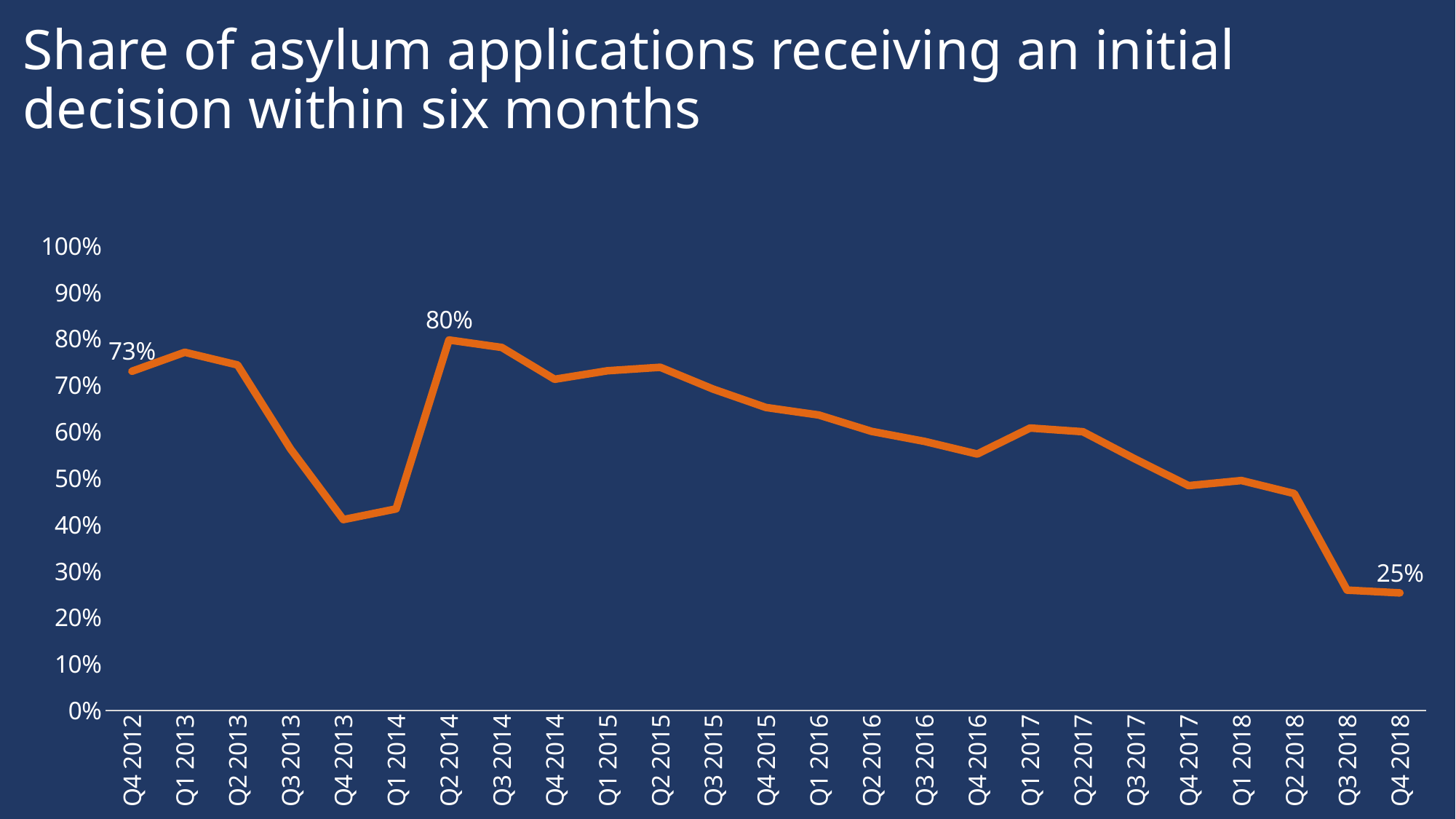
Is the value for Q4 2013 greater or less than 50%? less What is the difference between the value for Q4 2012 and the value for Q4 2018? 48 percentage points What type of chart is shown on the slide? Line chart Overall, does the share rise or fall from Q4 2012 to Q4 2018? Fall Which quarter has the highest share of asylum applications receiving an initial decision within six months? Q2 2014 What is the difference between the value for Q2 2014 and the value for Q4 2012? 7 percentage points What is the value for Q2 2014? 80% What is the value for Q4 2012? 73% What is the value for Q4 2018? 25% Which is larger, the value for Q4 2012 or the value for Q4 2018? Q4 2012 How many quarters are plotted on the x axis? 25 Is the value for Q4 2015 greater or less than 60%? greater